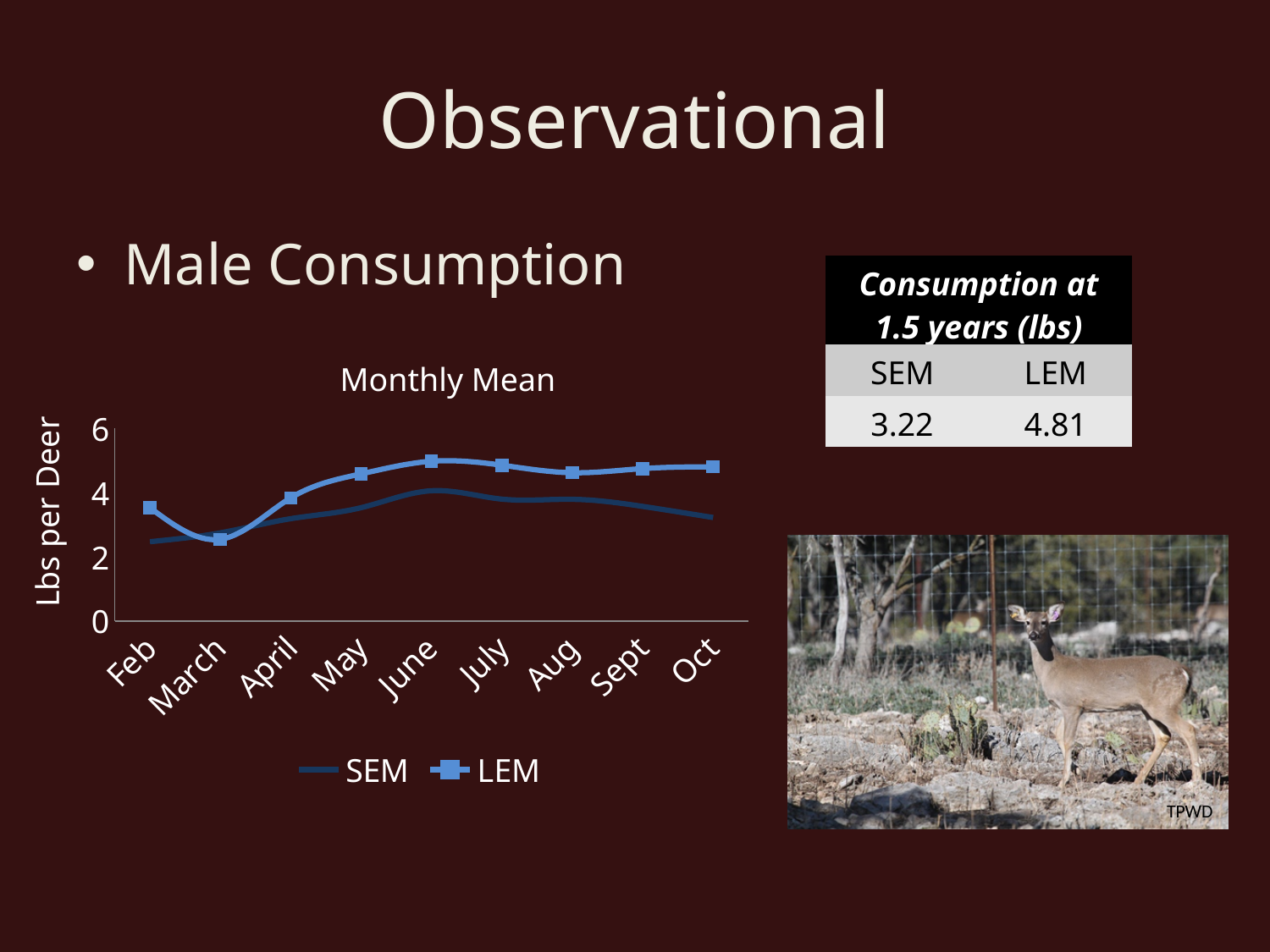
Does the SEM series rise or fall from June to Oct? fall Is the LEM value for March greater or less than 4? less How many series does the chart's legend list? 2 What kind of chart is shown on the slide? line chart Is the SEM value for Oct greater or less than 4? less What is the title of the chart? Monthly Mean How many months are plotted along the x axis of the chart? 9 Does the LEM series rise or fall from March to June? rise In which month is the LEM series at its lowest? March Is the LEM value for June greater or less than 4? greater Which series has the larger value in June, SEM or LEM? LEM What is the label on the chart's vertical axis? Lbs per Deer